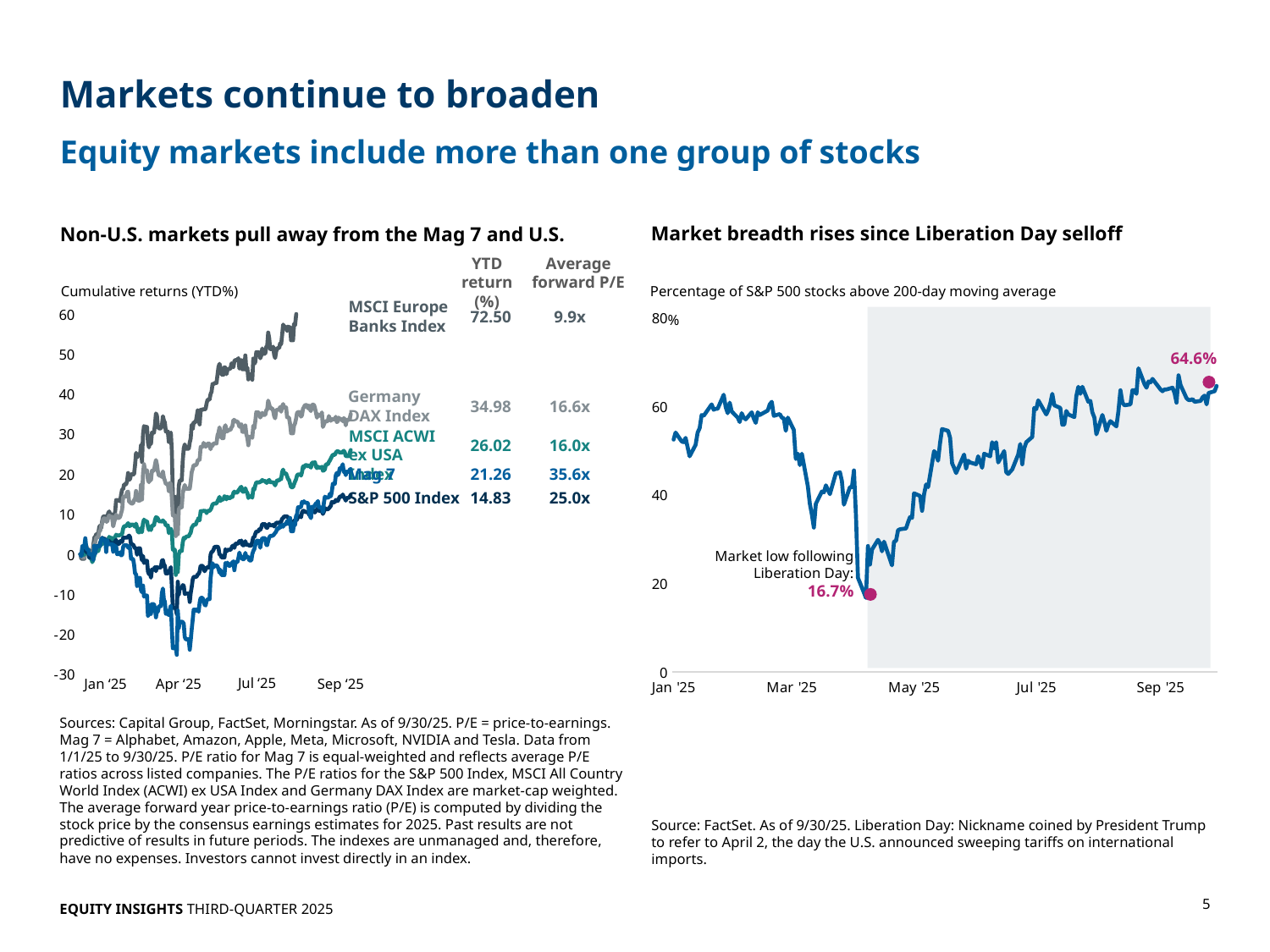
On the 'Non-U.S. markets pull away from the Mag 7 and U.S.' chart, which index has the highest YTD return? MSCI Europe Banks Index On the 'Market breadth rises since Liberation Day selloff' chart, what is the percentage of S&P 500 stocks above their 200-day moving average at the end of the series? 64.6% On the 'Non-U.S. markets pull away from the Mag 7 and U.S.' chart, what is the YTD return (%) for the S&P 500 Index? 14.83 On the 'Non-U.S. markets pull away from the Mag 7 and U.S.' chart, which has a higher average forward P/E, the Mag 7 or the S&P 500 Index? Mag 7 On the 'Market breadth rises since Liberation Day selloff' chart, what was the percentage of S&P 500 stocks above their 200-day moving average at the market low following Liberation Day? 16.7% On the 'Non-U.S. markets pull away from the Mag 7 and U.S.' chart, what is the average forward P/E for the Mag 7? 35.6x How many index series are plotted on the 'Non-U.S. markets pull away from the Mag 7 and U.S.' chart? 5 What kind of chart is 'Market breadth rises since Liberation Day selloff'? Line chart On the 'Non-U.S. markets pull away from the Mag 7 and U.S.' chart, what is the difference in YTD return between the Germany DAX Index and the S&P 500 Index? 20.15 On the 'Non-U.S. markets pull away from the Mag 7 and U.S.' chart, which index has the lowest YTD return? S&P 500 Index On the 'Market breadth rises since Liberation Day selloff' chart, does the percentage of S&P 500 stocks above their 200-day moving average rise or fall from the Liberation Day low to September 2025? Rise On the 'Non-U.S. markets pull away from the Mag 7 and U.S.' chart, what is the YTD return (%) for the MSCI Europe Banks Index? 72.50